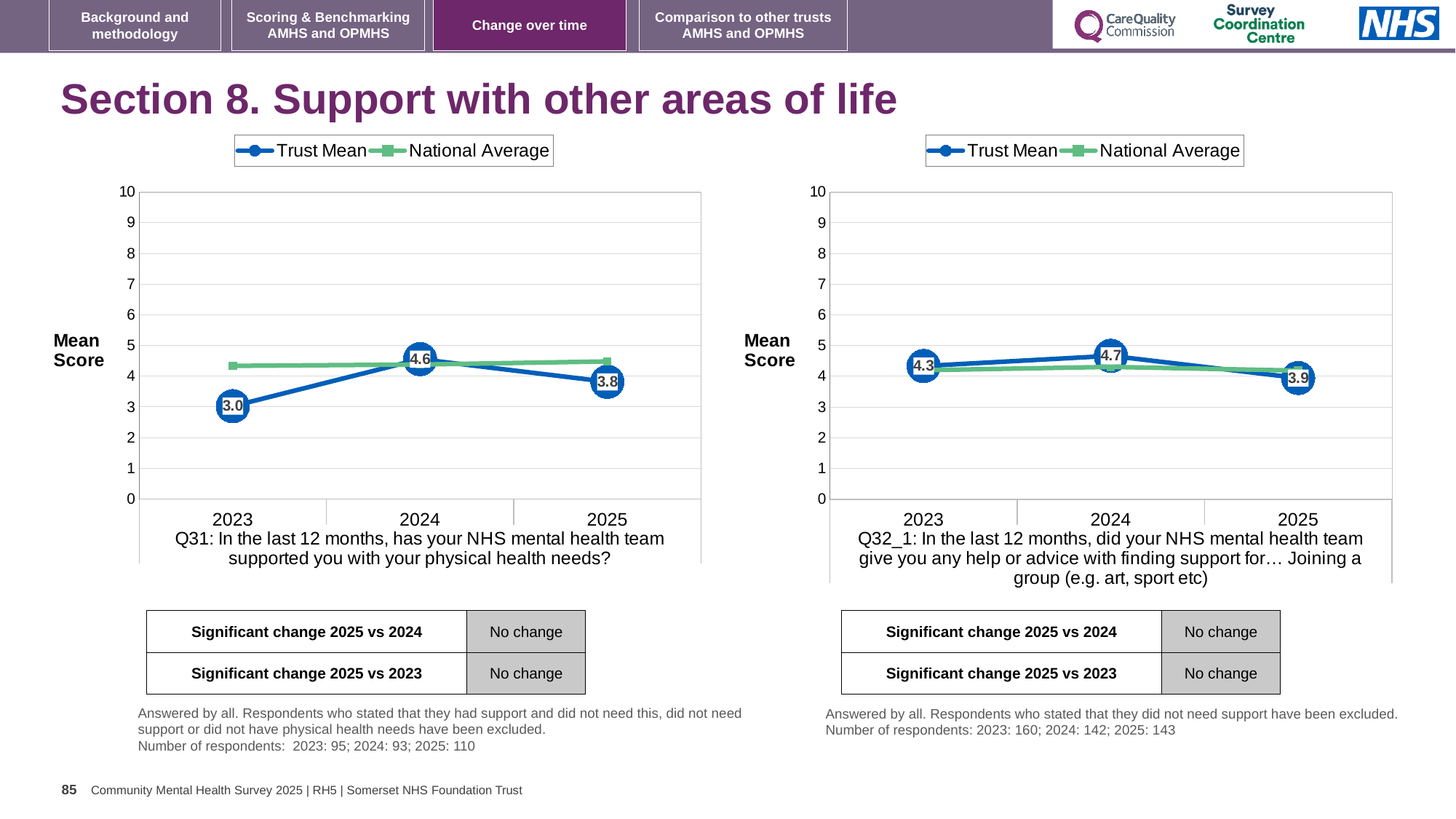
In the Q32_1 chart (right), which year has the lowest Trust Mean? 2025 In the Q31 chart (left), which year has the highest Trust Mean? 2024 In the Q31 chart (left), what is the difference between the Trust Mean for 2024 and 2023? 1.6 In the Q31 chart (left), what is the Trust Mean for 2023? 3.0 In the Q32_1 chart (right), what is the Trust Mean for 2025? 3.9 In the Q31 chart (left), what is the Trust Mean for 2024? 4.6 In the Q32_1 chart (right), what is the difference between the Trust Mean for 2024 and 2025? 0.8 In the Q31 chart (left), is the National Average for 2023 greater or less than 4? greater In the Q32_1 chart (right), what is the Trust Mean for 2023? 4.3 What type of chart is the Q31 chart (left)? Line chart How many series does the legend of the Q32_1 chart (right) list? 2 In the Q31 chart (left), what is the Trust Mean for 2025? 3.8